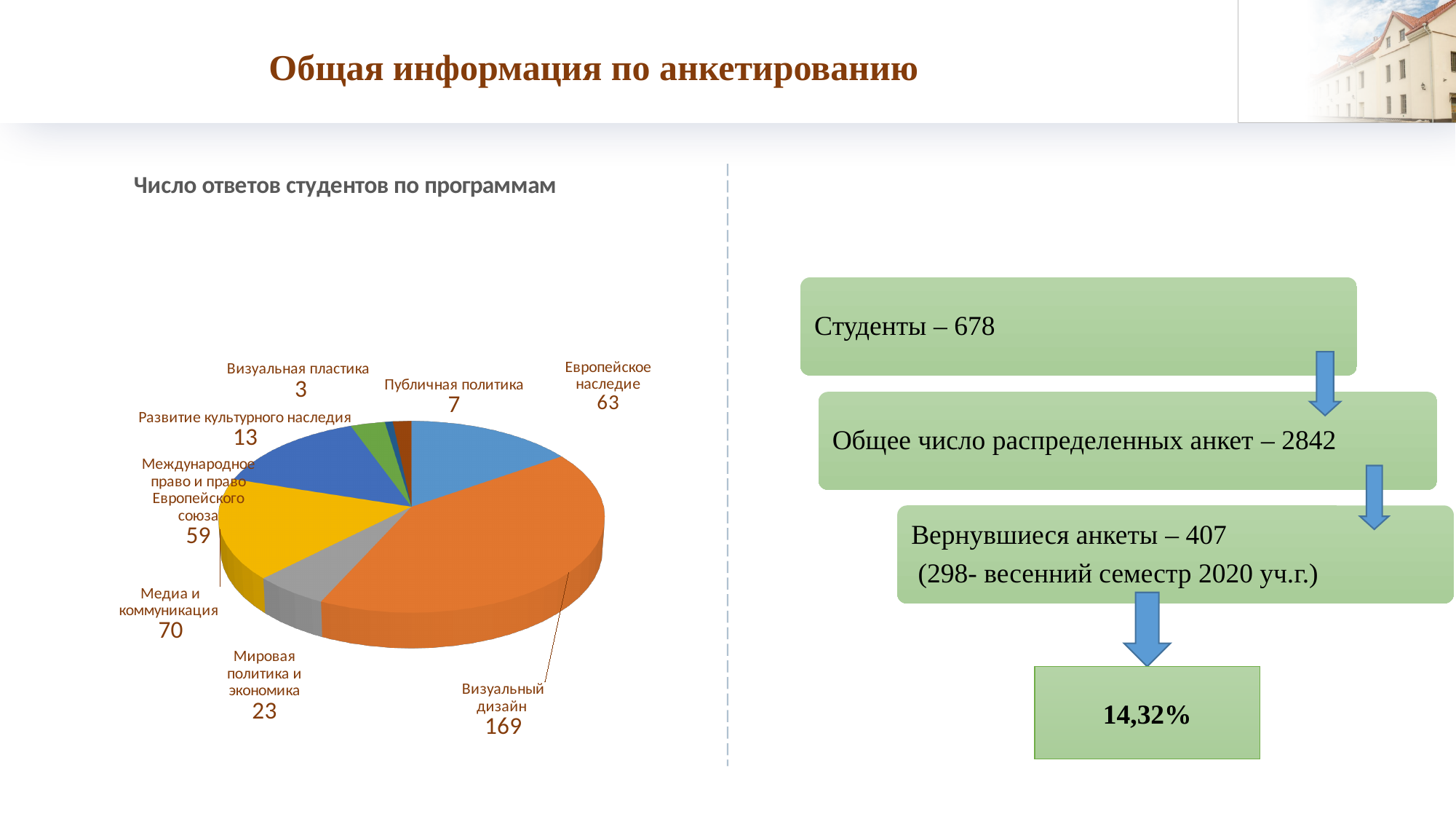
Which programme has the largest number of responses in the pie chart? Визуальный дизайн What is the difference between the responses for Визуальный дизайн and Медиа и коммуникация? 99 Which has more responses: Медиа и коммуникация or Европейское наследие? Медиа и коммуникация What is the value for Медиа и коммуникация in the pie chart? 70 What is the difference between the responses for Европейское наследие and Мировая политика и экономика? 40 How many programmes (slices) does the pie chart show? 8 What is the total number of responses across all programmes in the pie chart? 407 What is the title of the chart on the slide? Число ответов студентов по программам How many student responses are shown for Визуальный дизайн? 169 Which programme has the smallest number of responses in the pie chart? Визуальная пластика What kind of chart is shown on the slide? Pie chart What is the value for Международное право и право Европейского союза? 59